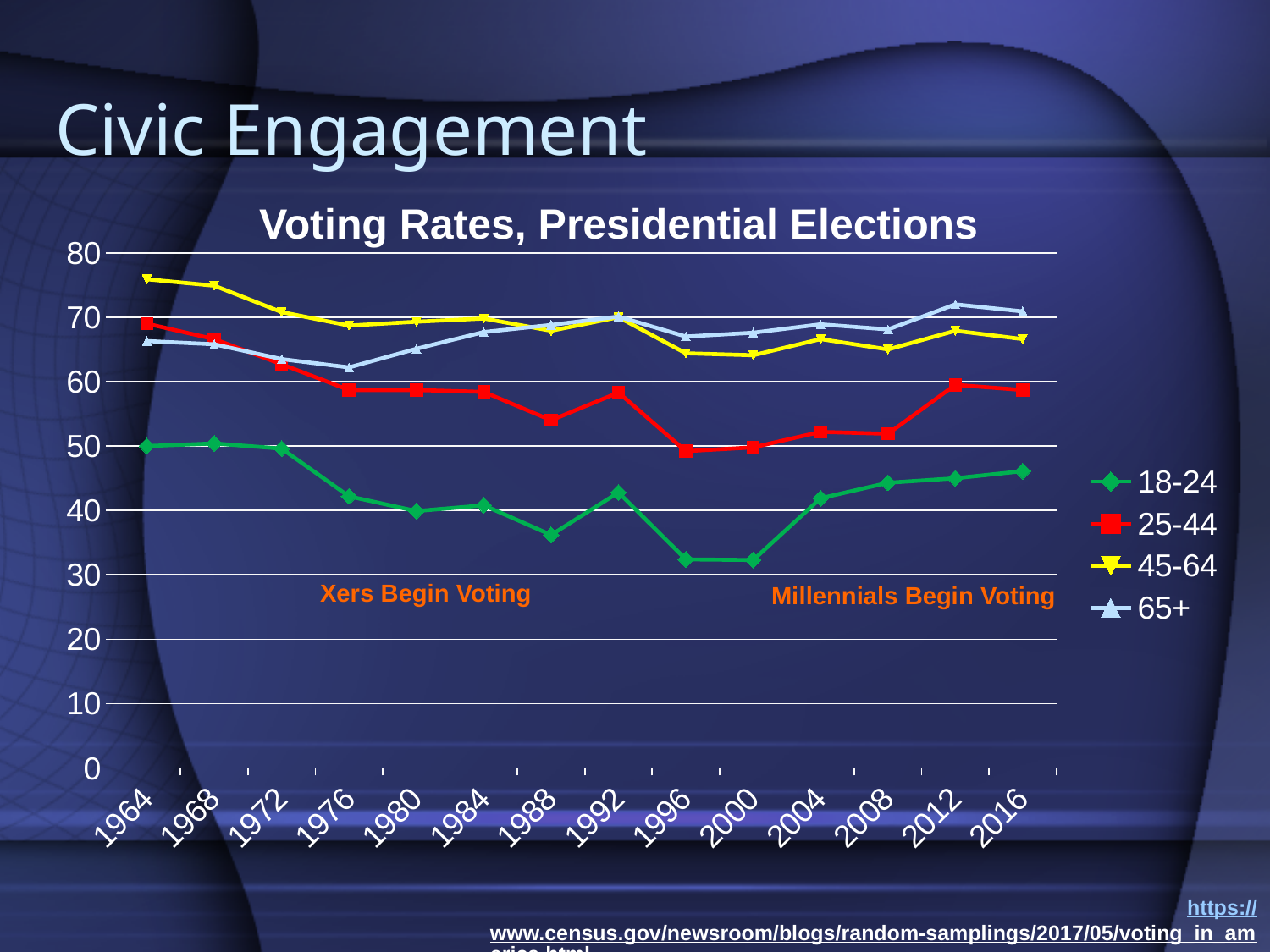
What is the title of the chart? Voting Rates, Presidential Elections Is the voting rate for the 45-64 group in 1964 greater or less than 70? greater In which year was the voting rate for the 65+ group lowest? 1976 How many election years are plotted along the x axis? 14 Is the voting rate for the 25-44 group in 1976 greater or less than 60? less What kind of chart is shown on the slide? line chart Which age group had the highest voting rate in 1964? 45-64 Which age group is shown by the yellow line? 45-64 Is the voting rate for the 18-24 group in 1996 greater or less than 40? less Which age group has the lowest voting rate across all years shown? 18-24 Does the voting rate for the 18-24 group rise or fall from 2000 to 2016? rise How many series does the legend list? 4